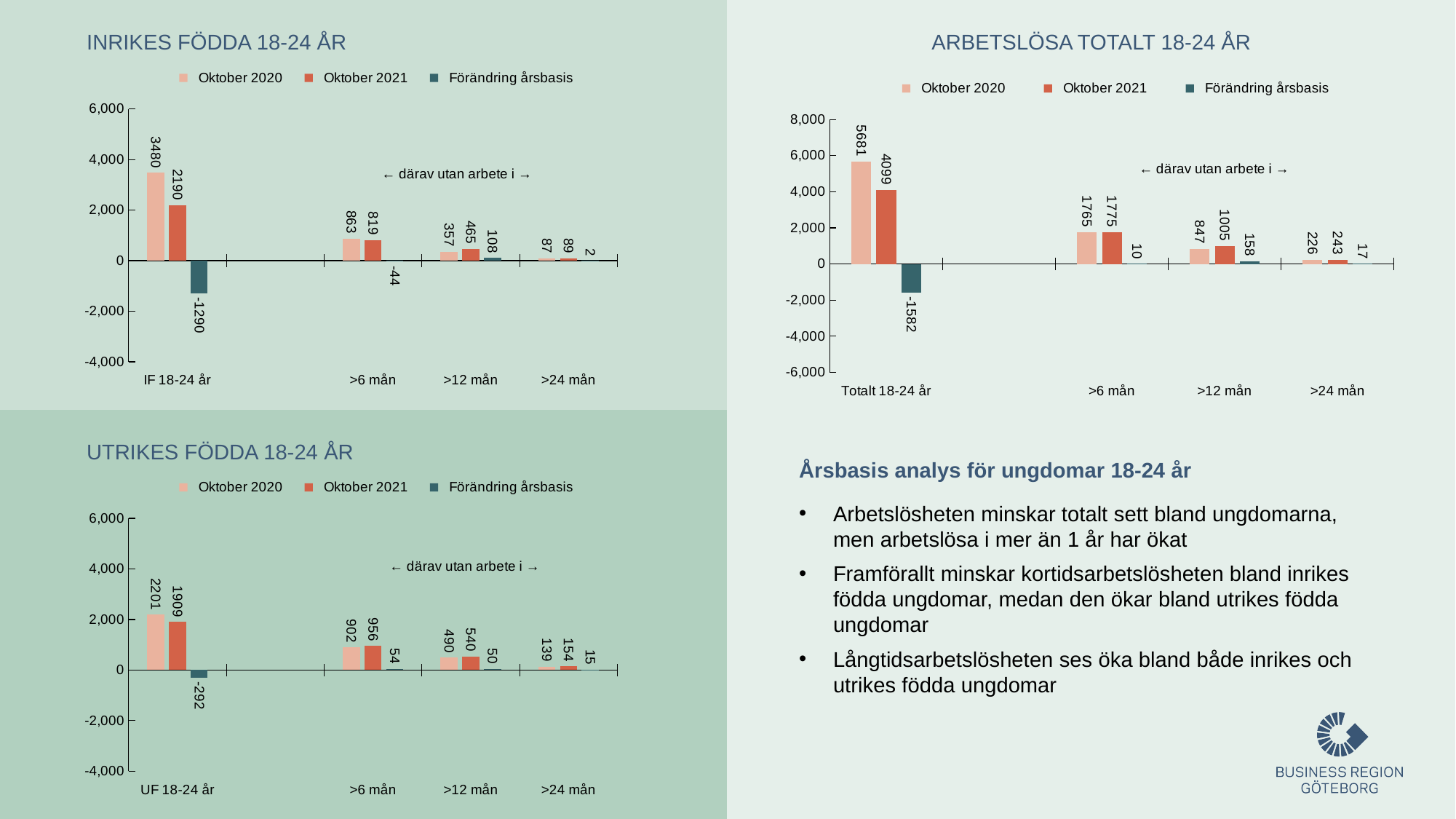
In the chart titled 'UTRIKES FÖDDA 18-24 ÅR', which is larger for >6 mån: the Oktober 2020 value or the Oktober 2021 value? Oktober 2021 In the chart titled 'UTRIKES FÖDDA 18-24 ÅR', what is the Förändring årsbasis value for UF 18-24 år? -292 In the chart titled 'UTRIKES FÖDDA 18-24 ÅR', what is the Oktober 2021 value for >12 mån? 540 In the chart titled 'UTRIKES FÖDDA 18-24 ÅR', how many categories are shown on the x axis? 4 In the chart titled 'ARBETSLÖSA TOTALT 18-24 ÅR', what is the Oktober 2021 value for Totalt 18-24 år? 4099 In the chart titled 'INRIKES FÖDDA 18-24 ÅR', what is the difference between the Oktober 2020 and Oktober 2021 values for >6 mån? 44 What kind of chart is the chart titled 'INRIKES FÖDDA 18-24 ÅR'? Bar chart In the chart titled 'ARBETSLÖSA TOTALT 18-24 ÅR', which category has the highest Oktober 2020 value? Totalt 18-24 år In the chart titled 'ARBETSLÖSA TOTALT 18-24 ÅR', how many series does the legend list? 3 In the chart titled 'ARBETSLÖSA TOTALT 18-24 ÅR', what is the difference between the Oktober 2021 and Oktober 2020 values for >12 mån? 158 In the chart titled 'INRIKES FÖDDA 18-24 ÅR', what is the Förändring årsbasis value for IF 18-24 år? -1290 In the chart titled 'INRIKES FÖDDA 18-24 ÅR', what is the Oktober 2020 value for IF 18-24 år? 3480